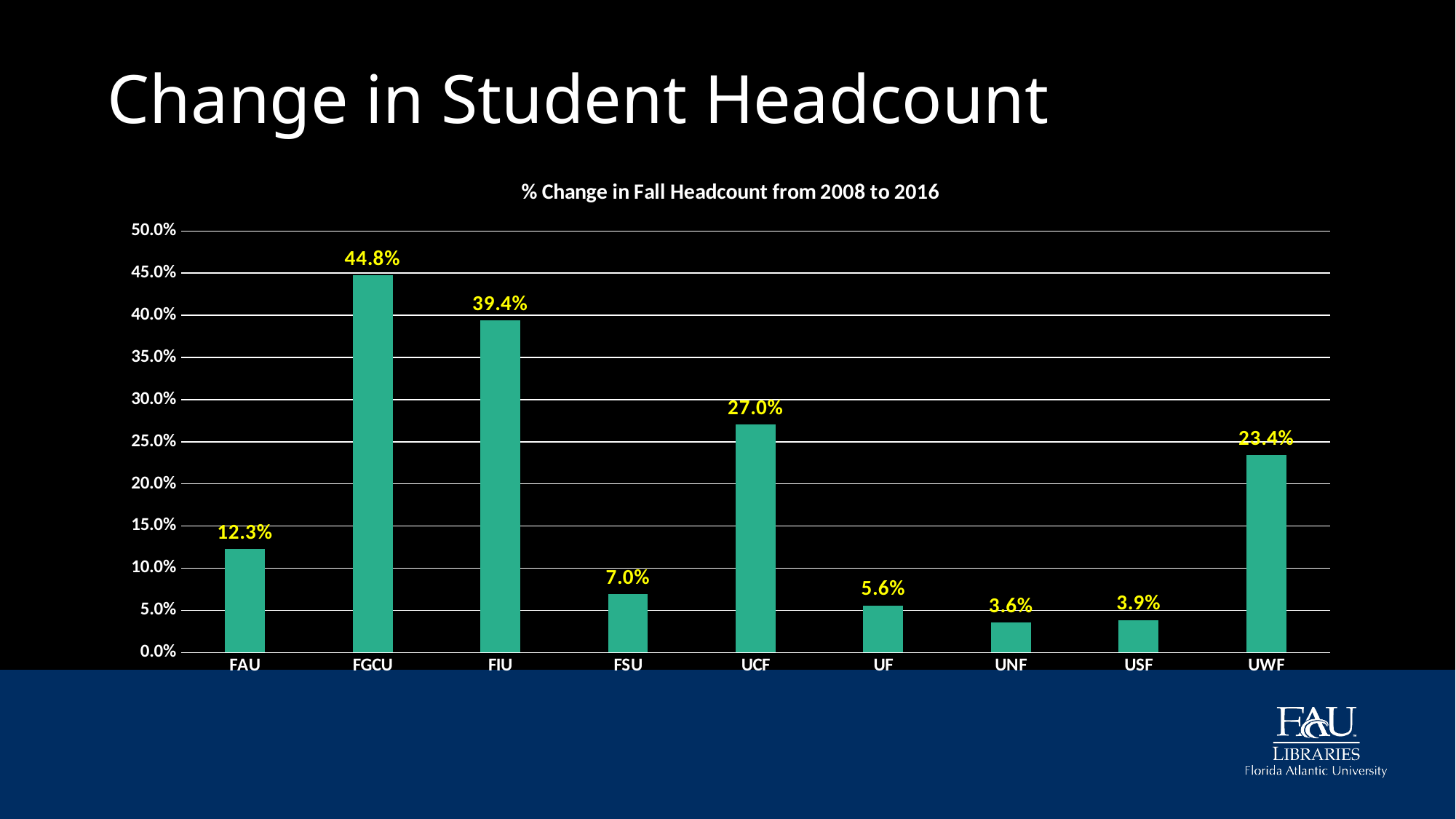
Which has a larger % change in fall headcount, UCF or UWF? UCF Is the value for FIU greater or less than 35.0%? greater What is the difference between the % change for USF and UNF? 0.3% Which university has the lowest % change in fall headcount? UNF Which university has the highest % change in fall headcount? FGCU How many universities are shown on the x axis? 9 What is the % change in fall headcount for UNF? 3.6% What is the difference between the % change for FGCU and FIU? 5.4% What kind of chart is shown on the slide? Bar chart What is the title of the chart? % Change in Fall Headcount from 2008 to 2016 What is the % change in fall headcount for FAU? 12.3% What is the % change in fall headcount for UCF? 27.0%